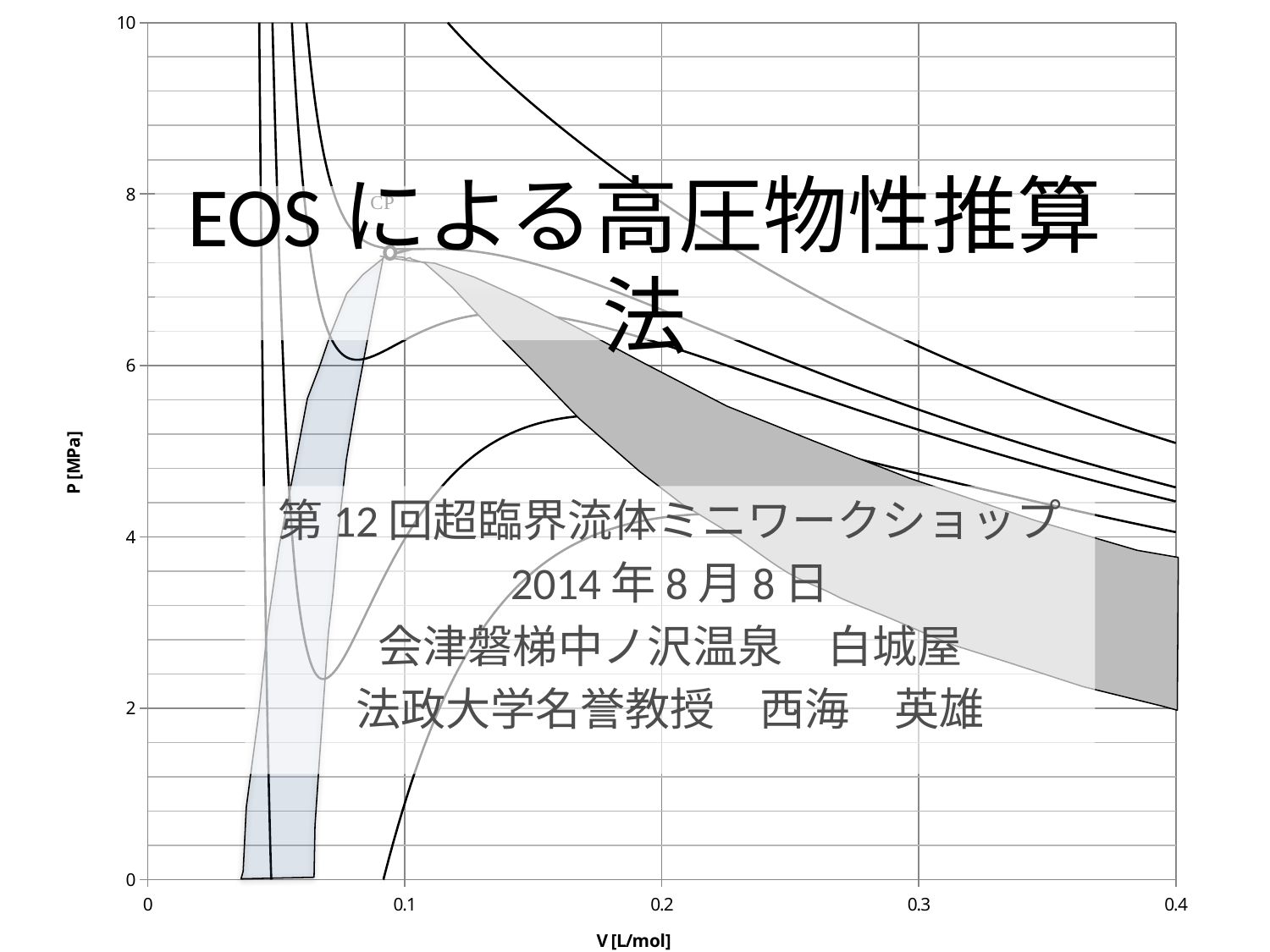
What is the maximum value shown on the vertical axis of the chart? 10 Is the volume at the point labelled CP greater or less than 0.2 L/mol? less Is the pressure at the point labelled CP greater or less than 8 MPa? less Along the horizontal axis from V = 0.2 to V = 0.4, do the plotted curves rise or fall? fall What kind of chart is shown on the slide? line chart Is the pressure at the point labelled CP greater or less than 6 MPa? greater What is the maximum value shown on the horizontal axis of the chart? 0.4 What is the label of the horizontal axis of the chart? V [L/mol] What is the label of the vertical axis of the chart? P [MPa]